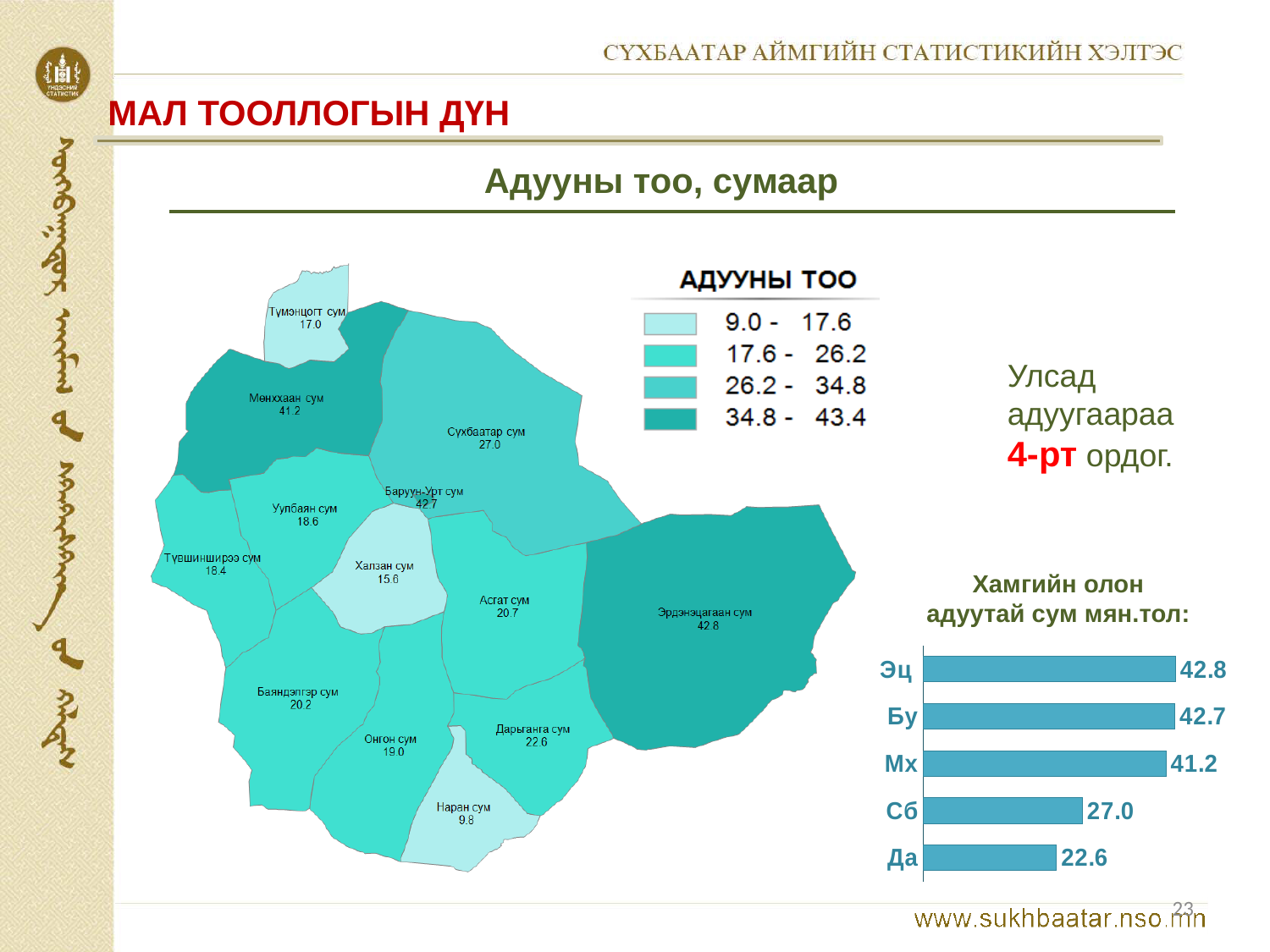
In the bar chart 'Хамгийн олон адуутай сум мян.тол:', which category has the lowest value? Да In the bar chart 'Хамгийн олон адуутай сум мян.тол:', what is the difference between the values for Мх and Сб? 14.2 In the bar chart 'Хамгийн олон адуутай сум мян.тол:', what is the value for Да? 22.6 On the map 'Адууны тоо', what value is shown for Эрдэнэцагаан сум? 42.8 On the map 'Адууны тоо', what value is shown for Наран сум? 9.8 What kind of chart is 'Хамгийн олон адуутай сум мян.тол:'? bar chart In the bar chart 'Хамгийн олон адуутай сум мян.тол:', which is larger, the value for Сб or the value for Да? Сб In the bar chart 'Хамгийн олон адуутай сум мян.тол:', what is the value for Сб? 27.0 How many categories are shown in the bar chart 'Хамгийн олон адуутай сум мян.тол:'? 5 How many value ranges does the legend of the map 'Адууны тоо' list? 4 In the bar chart 'Хамгийн олон адуутай сум мян.тол:', which category has the highest value? Эц In the bar chart 'Хамгийн олон адуутай сум мян.тол:', what is the value for Эц? 42.8